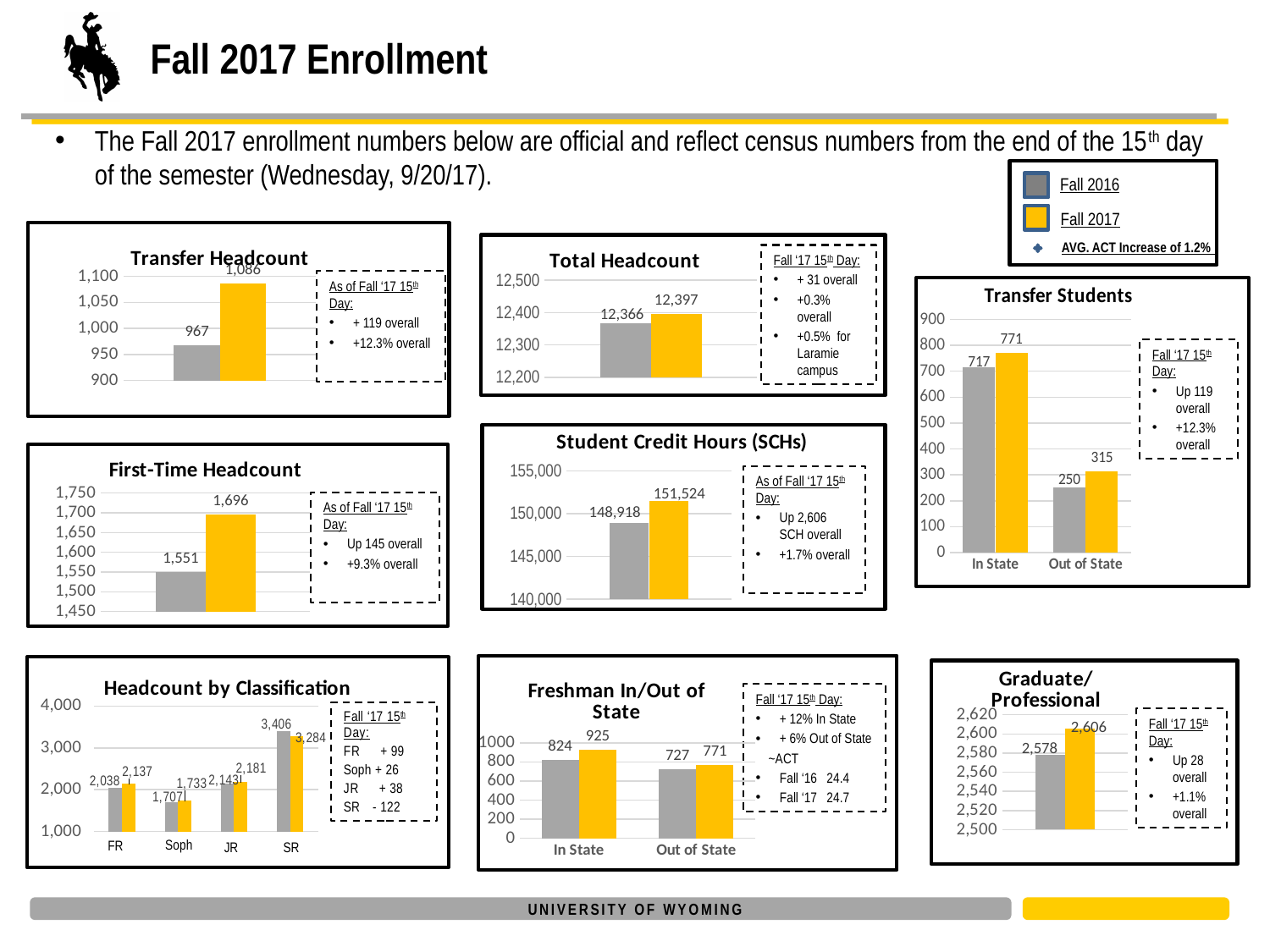
In the Student Credit Hours (SCHs) chart, what is the Fall 2017 value? 151,524 In the First-Time Headcount chart, what is the Fall 2016 value? 1,551 In the Headcount by Classification chart, is the Fall 2016 value for SR larger or smaller than the Fall 2017 value for SR? larger In the Freshman In/Out of State chart, what is the difference between the Fall 2017 and Fall 2016 values for In State? 101 In the Transfer Students chart, which category has the highest value? In State In the Transfer Headcount chart, what is the Fall 2017 value? 1,086 In the Transfer Students chart, what is the Fall 2017 value for Out of State? 315 What type of chart is the Freshman In/Out of State chart? bar chart In the Total Headcount chart, what is the difference between the Fall 2017 and Fall 2016 values? 31 In the Graduate/Professional chart, what is the Fall 2016 value? 2,578 In the Headcount by Classification chart, which classification has the lowest Fall 2017 value? Soph In the Headcount by Classification chart, how many classification categories are shown? 4